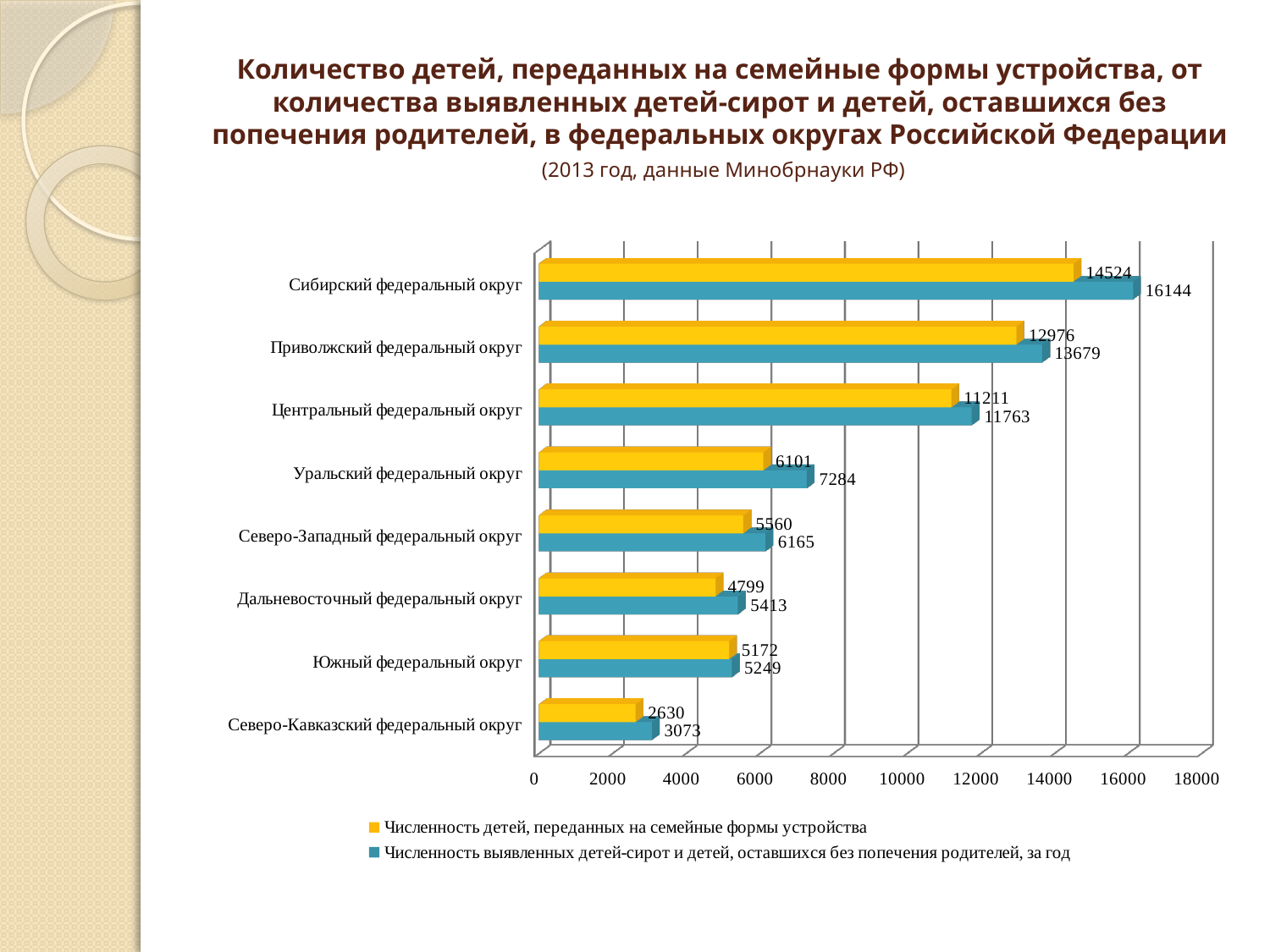
What is the value of 'Численность детей, переданных на семейные формы устройства' for Северо-Кавказский федеральный округ? 2630 What is the difference between the two series values for Сибирский федеральный округ (16144 and 14524)? 1620 Which federal district has the highest value for 'Численность выявленных детей-сирот и детей, оставшихся без попечения родителей, за год'? Сибирский федеральный округ How many federal districts (categories) are shown in the chart? 8 What is the value of 'Численность детей, переданных на семейные формы устройства' for Сибирский федеральный округ? 14524 Which colour represents 'Численность детей, переданных на семейные формы устройства' in the chart? Yellow Which federal district has the lowest value for 'Численность детей, переданных на семейные формы устройства'? Северо-Кавказский федеральный округ Is the value of 'Численность выявленных детей-сирот и детей, оставшихся без попечения родителей, за год' for Центральный федеральный округ greater or less than 10000? greater What type of chart is shown on the slide? Bar chart What is the value of 'Численность выявленных детей-сирот и детей, оставшихся без попечения родителей, за год' for Уральский федеральный округ? 7284 How many series does the legend list? 2 Which is larger: 'Численность детей, переданных на семейные формы устройства' for Южный федеральный округ or for Дальневосточный федеральный округ? Южный федеральный округ